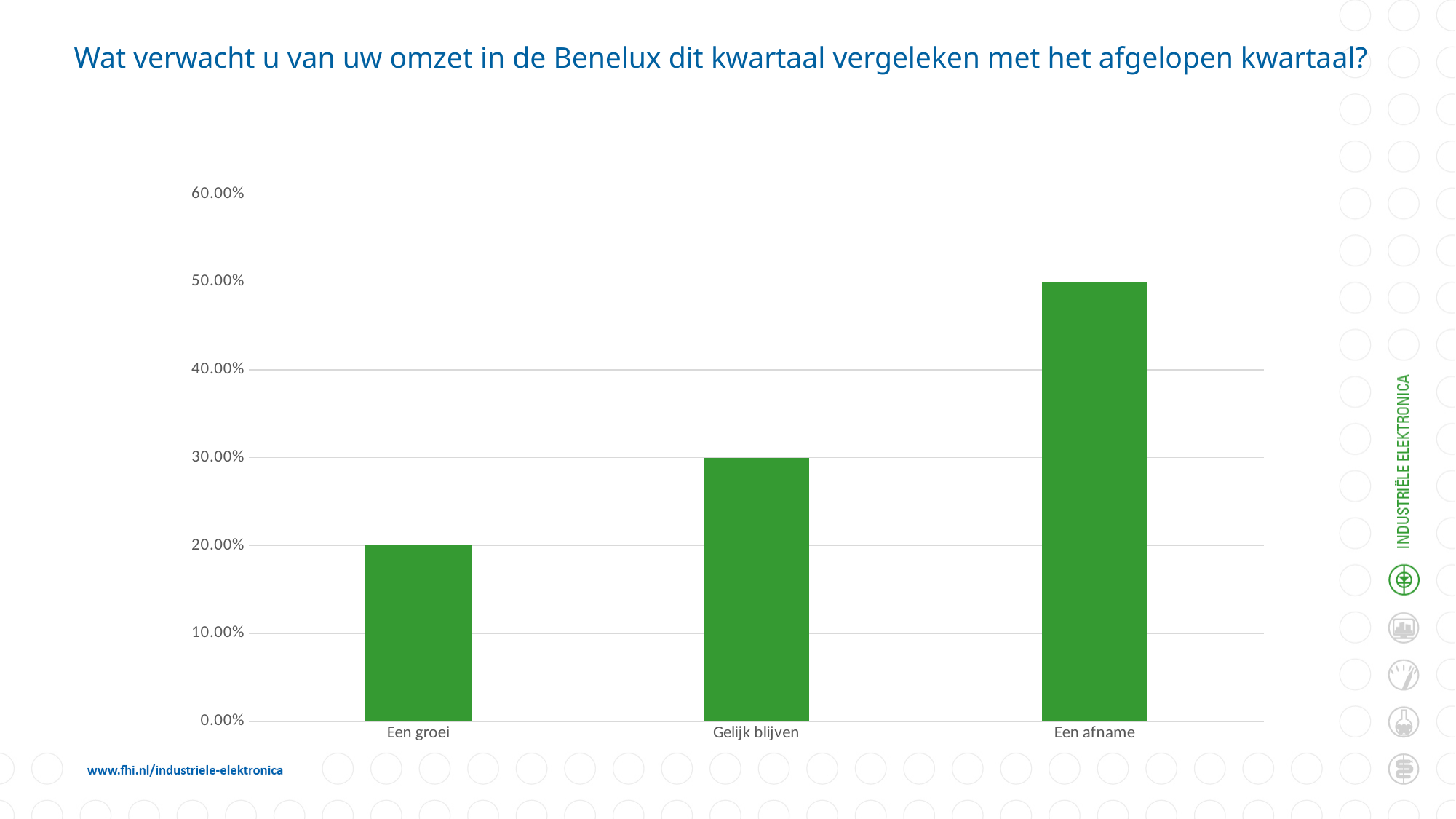
Which is larger, the value for Gelijk blijven or the value for Een afname? Een afname What is the difference between the values for Een afname and Een groei? 30.00% What is the value for Gelijk blijven? 30.00% Which category has the highest value? Een afname What kind of chart is shown on the slide? bar chart What is the difference between the values for Gelijk blijven and Een groei? 10.00% What is the value for Een groei? 20.00% Is the value for Een afname greater or less than 40.00%? greater How many categories are shown on the x axis? 3 Which category has the lowest value? Een groei Do the values rise or fall from left to right along the x axis? rise What is the value for Een afname? 50.00%